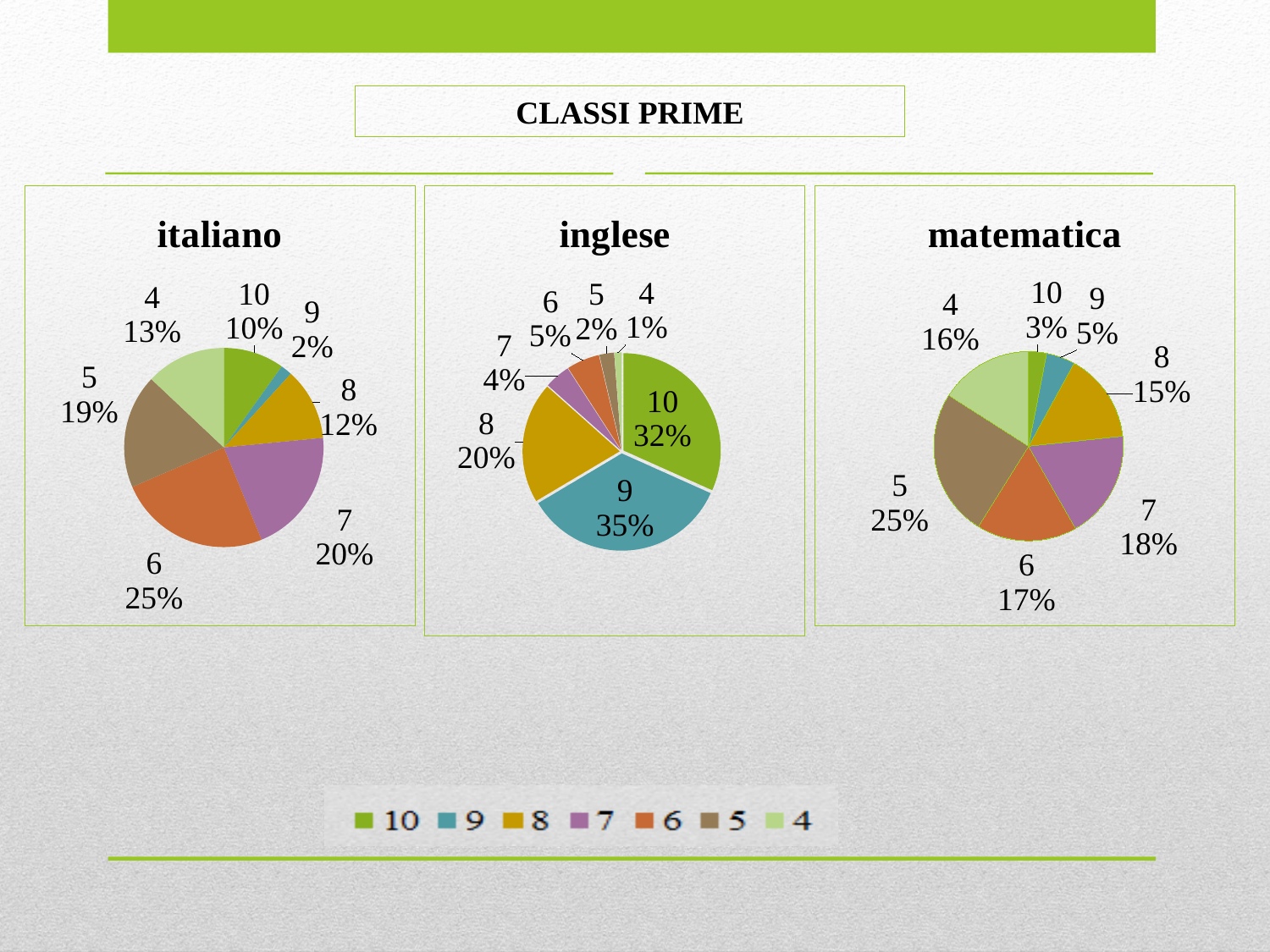
In the 'matematica' pie chart, which has a larger share, grade 7 or grade 8? 7 What type of chart is used for 'italiano'? pie chart In the 'italiano' pie chart, what share does grade 6 have? 25% How many slices does the 'inglese' pie chart have? 7 In the 'inglese' pie chart, which grade has the smallest share? 4 In the 'matematica' pie chart, what share does grade 5 have? 25% In the 'matematica' pie chart, which grade has the largest share? 5 In the 'inglese' pie chart, what share does grade 9 have? 35% In the 'inglese' pie chart, which grade has the largest share? 9 In the 'italiano' pie chart, which grade has the smallest share? 9 How many entries does the legend at the bottom of the slide list? 7 In the 'italiano' pie chart, what is the difference between the shares of grade 6 and grade 7? 5%